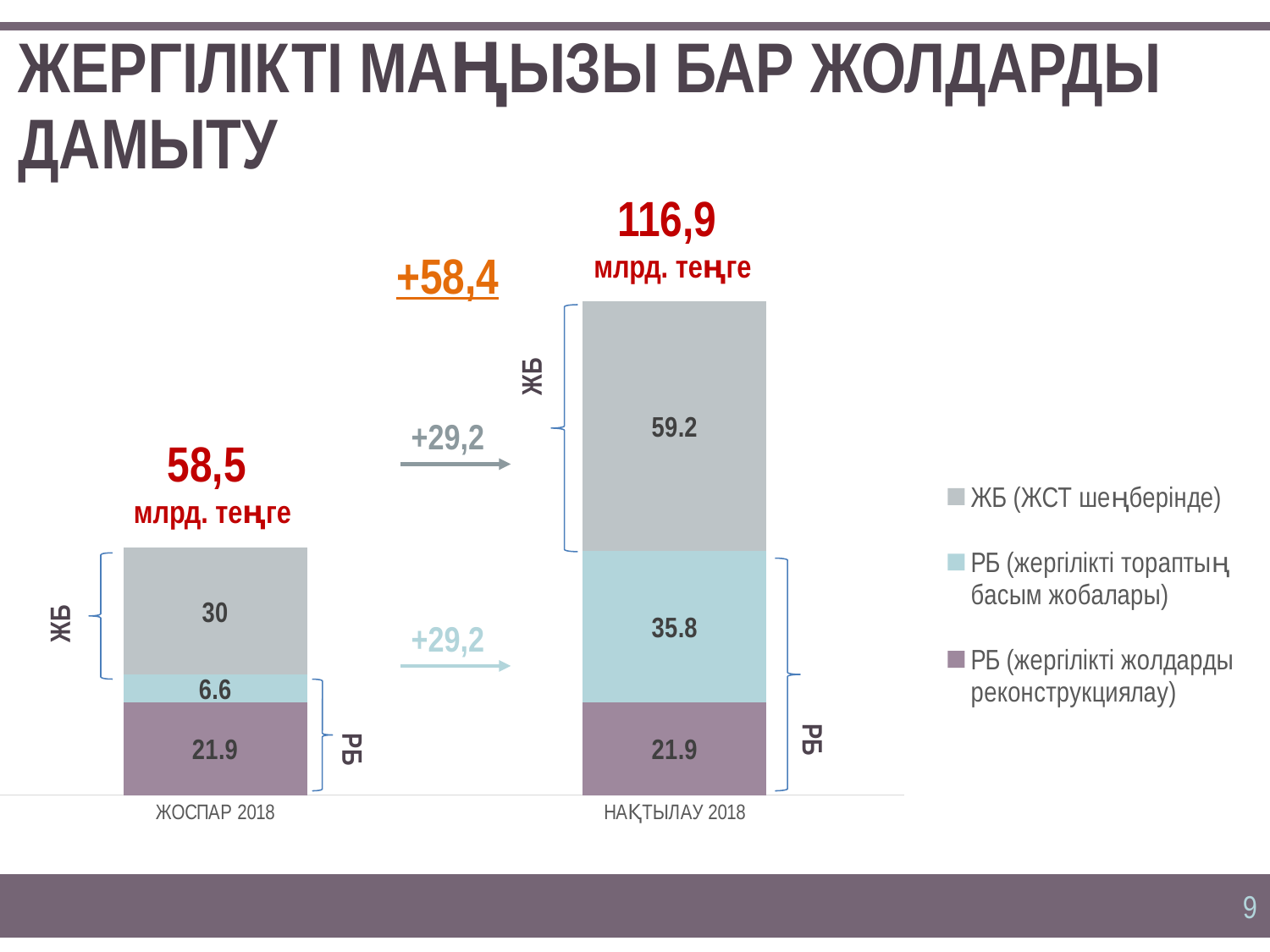
How many categories are shown on the x axis of the chart? 2 What kind of chart is shown on the slide? Stacked bar chart What is the total shown for the НАҚТЫЛАУ 2018 bar? 116,9 млрд. теңге What is the value of the РБ (жергілікті тораптың басым жобалары) segment for НАҚТЫЛАУ 2018? 35.8 What is the value of the РБ (жергілікті жолдарды реконструкциялау) segment for НАҚТЫЛАУ 2018? 21.9 What is the difference between the ЖБ (ЖСТ шеңберінде) values for НАҚТЫЛАУ 2018 and ЖОСПАР 2018? 29.2 What is the value of the ЖБ (ЖСТ шеңберінде) segment for НАҚТЫЛАУ 2018? 59.2 What is the value of the РБ (жергілікті тораптың басым жобалары) segment for ЖОСПАР 2018? 6.6 What is the value of the ЖБ (ЖСТ шеңберінде) segment for ЖОСПАР 2018? 30 What is the total shown for the ЖОСПАР 2018 bar? 58,5 млрд. теңге How many series does the legend list? 3 Which category has the larger РБ (жергілікті тораптың басым жобалары) value, ЖОСПАР 2018 or НАҚТЫЛАУ 2018? НАҚТЫЛАУ 2018